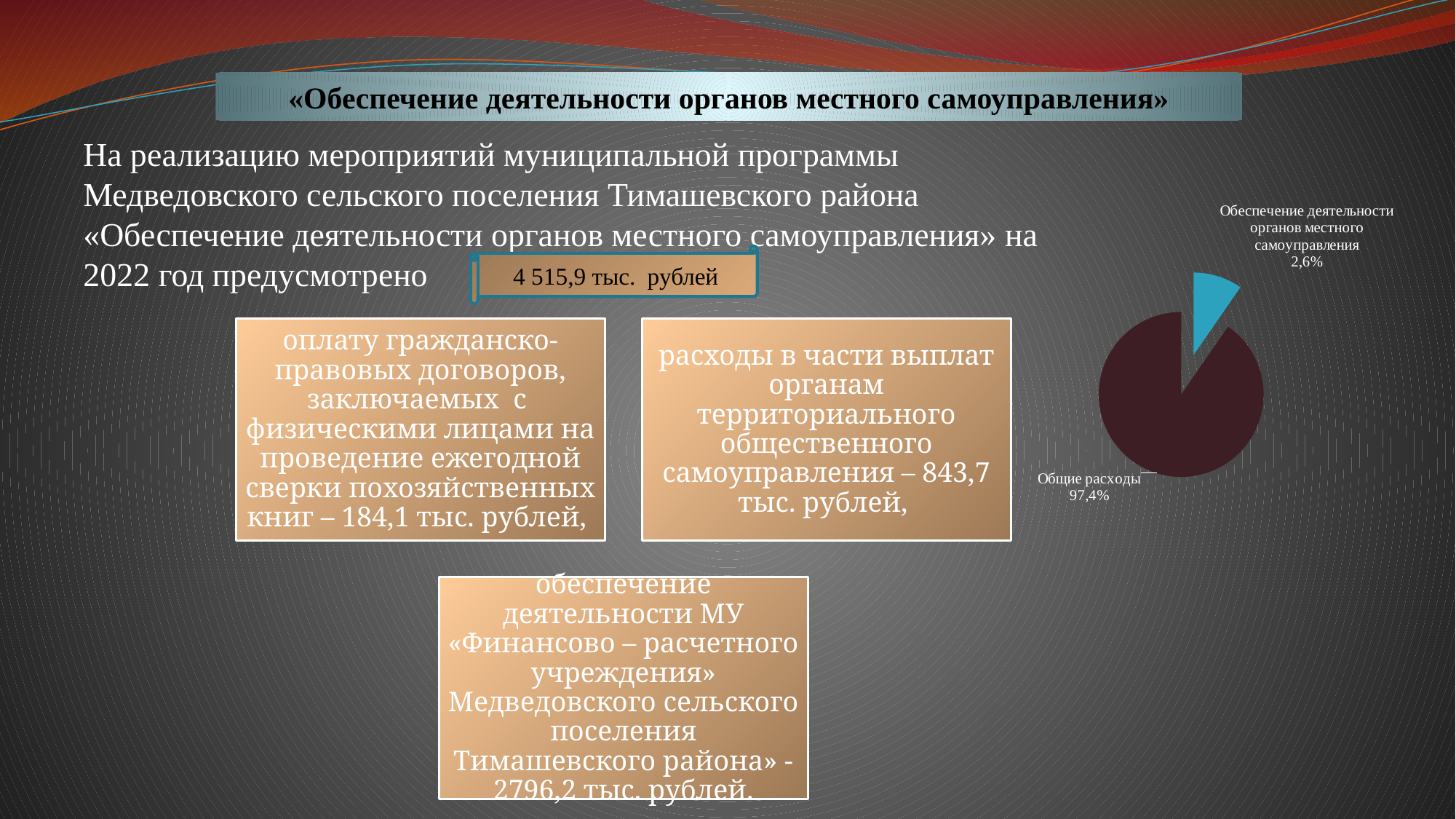
What is the difference in percentage points between the "Общие расходы" slice and the "Обеспечение деятельности органов местного самоуправления" slice? 94,8 What kind of chart is shown on the right side of the slide? pie chart What colour is the "Обеспечение деятельности органов местного самоуправления" slice in the pie chart? blue Which slice of the pie chart is the largest? Общие расходы Which is larger in the pie chart: "Общие расходы" or "Обеспечение деятельности органов местного самоуправления"? Общие расходы Which slice of the pie chart is the smallest? Обеспечение деятельности органов местного самоуправления What share of the pie chart is labelled "Обеспечение деятельности органов местного самоуправления"? 2,6% How many slices does the pie chart have? 2 What share of the pie chart is labelled "Общие расходы"? 97,4% What colour is the "Общие расходы" slice in the pie chart? dark brown What is the total of the two percentages shown on the pie chart? 100%